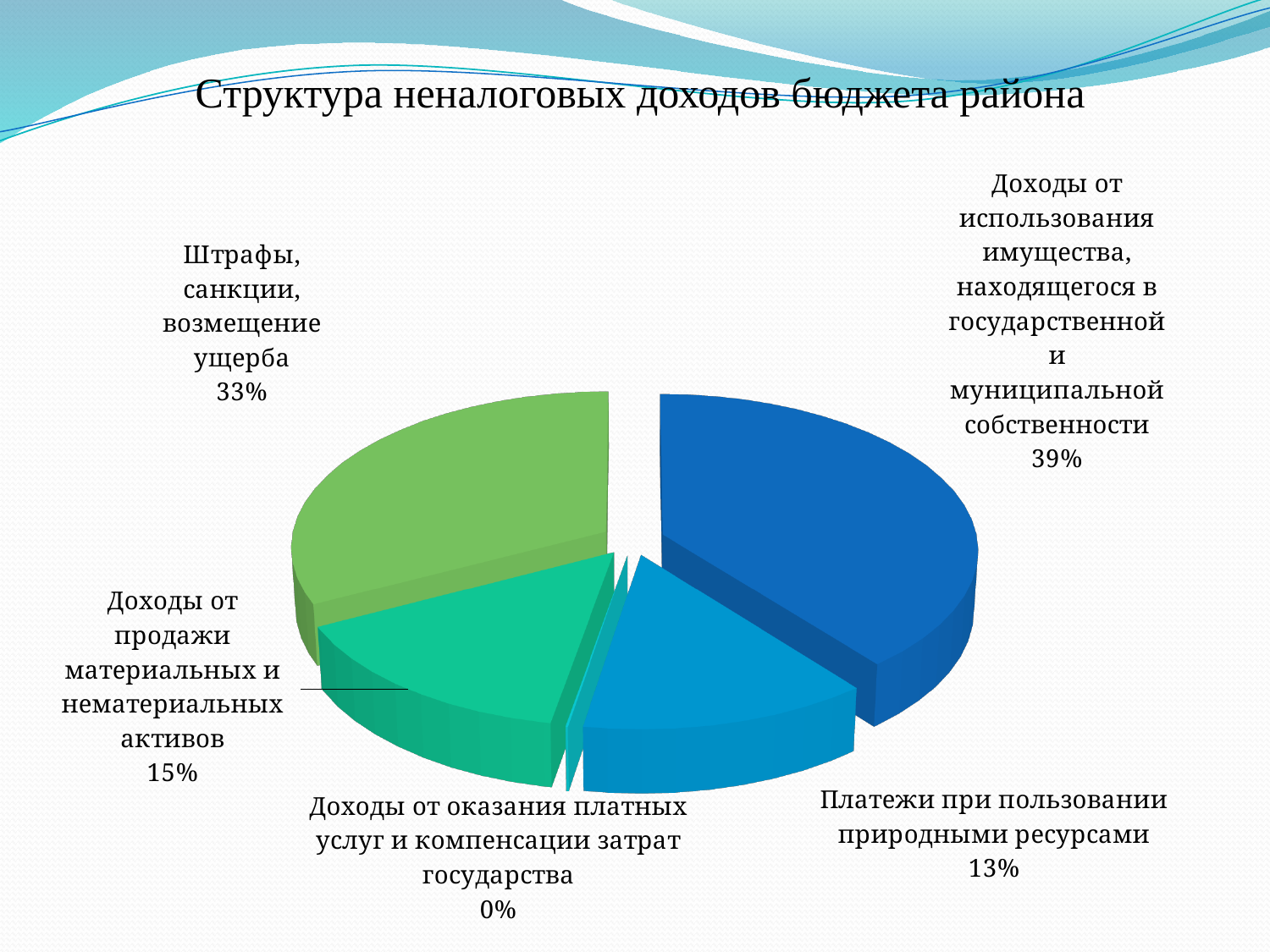
What is the difference in percentage points between 'Доходы от использования имущества, находящегося в государственной и муниципальной собственности' and 'Штрафы, санкции, возмещение ущерба'? 6 percentage points What share of the pie is 'Штрафы, санкции, возмещение ущерба'? 33% Which is larger: the share for 'Доходы от продажи материальных и нематериальных активов' or the share for 'Платежи при пользовании природными ресурсами'? Доходы от продажи материальных и нематериальных активов Which category has the largest share of the pie? Доходы от использования имущества, находящегося в государственной и муниципальной собственности What colour is the slice for 'Штрафы, санкции, возмещение ущерба'? Green What is the chart's title? Структура неналоговых доходов бюджета района What share of the pie is 'Платежи при пользовании природными ресурсами'? 13% What type of chart is shown on the slide? Pie chart What share of the pie is 'Доходы от продажи материальных и нематериальных активов'? 15% How many categories (slices) does the pie chart show? 5 Which category has the smallest share of the pie? Доходы от оказания платных услуг и компенсации затрат государства